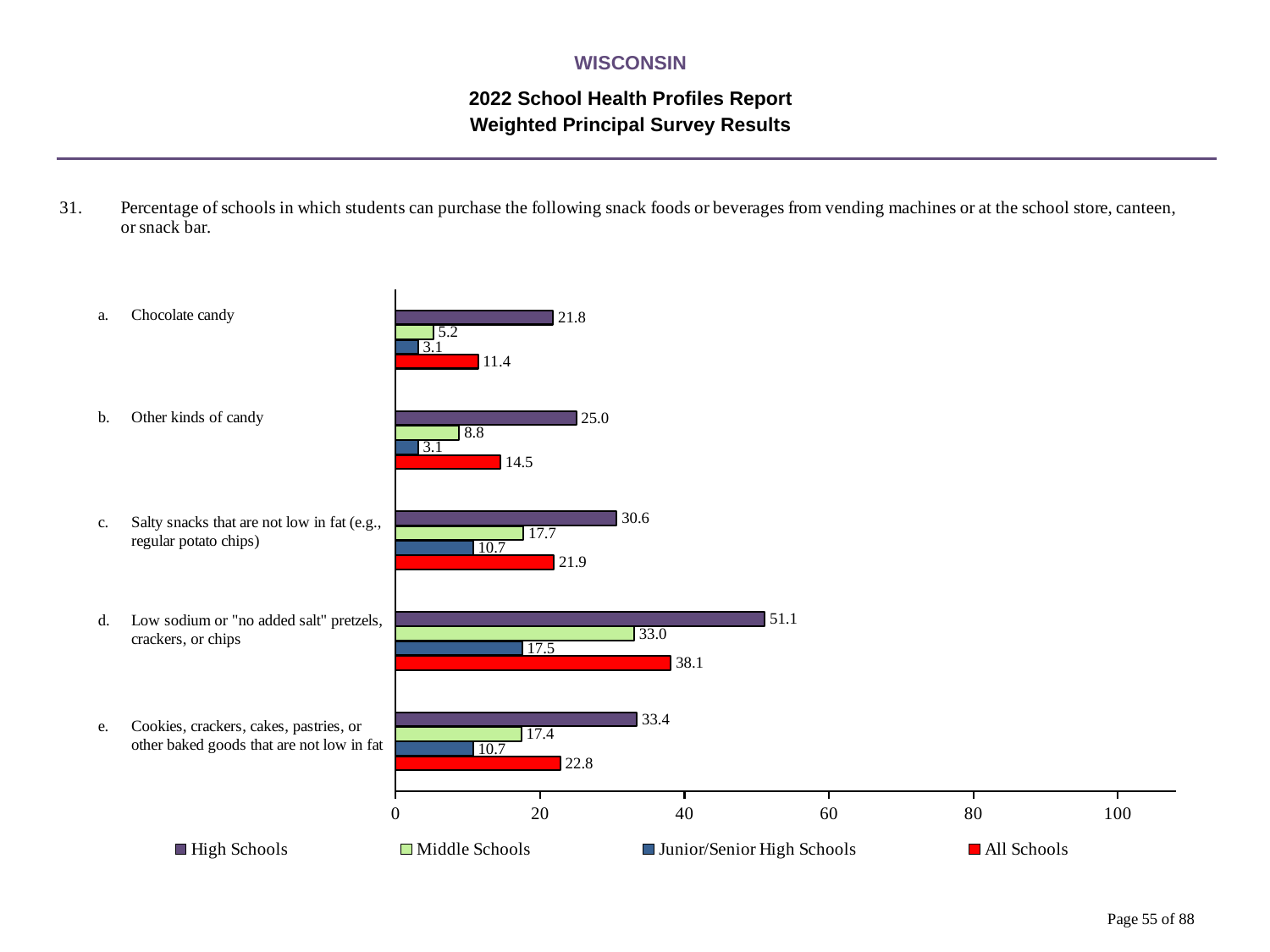
What is the value for All Schools for Low sodium or "no added salt" pretzels, crackers, or chips? 38.1 Which is larger for Cookies, crackers, cakes, pastries, or other baked goods that are not low in fat: the Middle Schools value or the All Schools value? All Schools How many series does the legend list? 4 Is the High Schools value for Low sodium or "no added salt" pretzels, crackers, or chips greater or less than 40? greater What is the value for High Schools for Chocolate candy? 21.8 Which colour represents All Schools in the legend? Red What is the value for Junior/Senior High Schools for Salty snacks that are not low in fat? 10.7 Which category has the lowest value for All Schools? Chocolate candy Which category has the highest value for Middle Schools? Low sodium or "no added salt" pretzels, crackers, or chips What is the difference between the High Schools and Middle Schools values for Other kinds of candy? 16.2 How many snack food categories are shown in the chart? 5 What kind of chart is shown on the slide? Bar chart